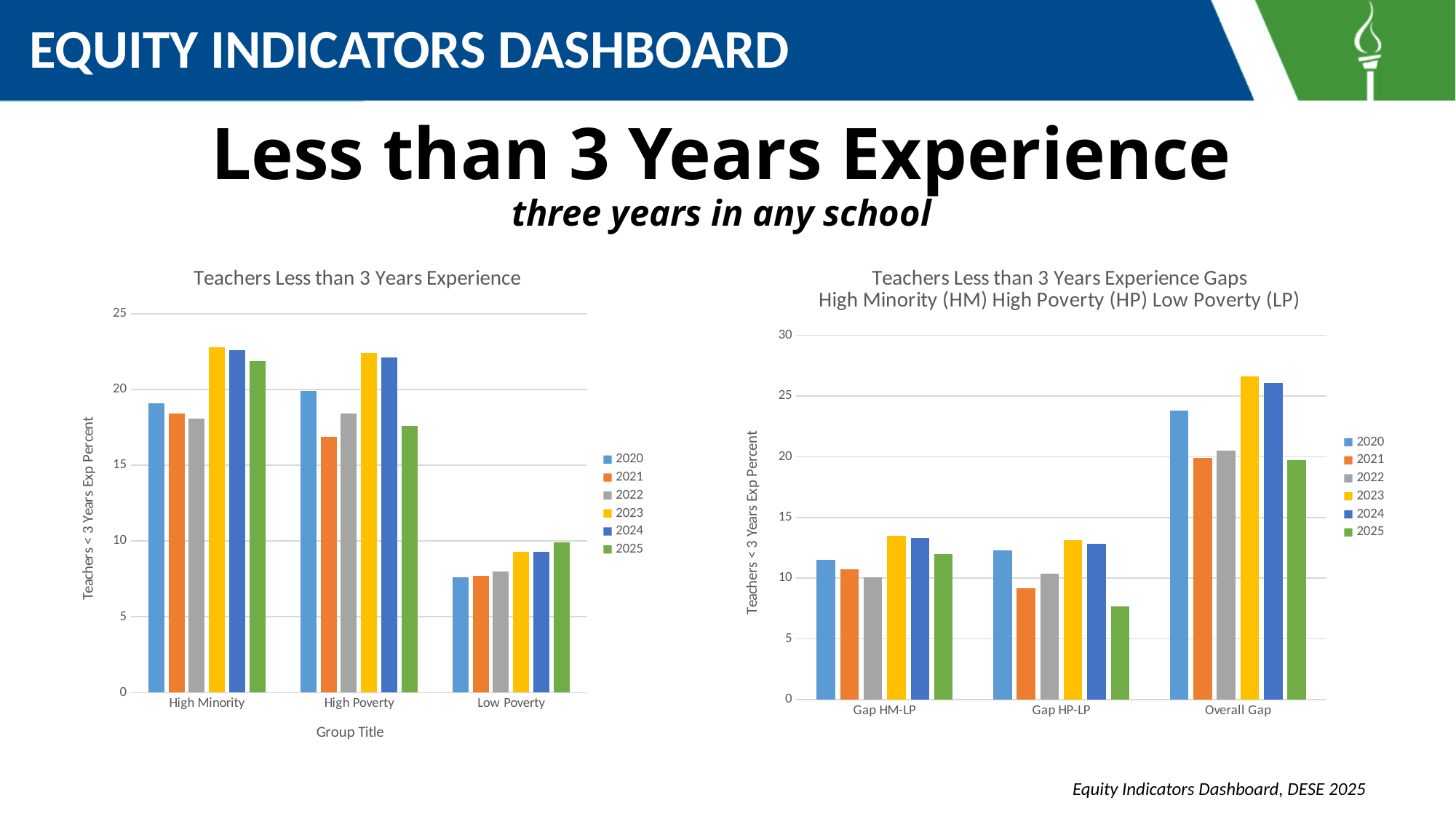
In the left chart, is the value for Low Poverty in 2020 greater or less than 10? less In the left chart, for High Poverty, which is larger: the 2021 value or the 2022 value? 2022 In the right chart, which category has the highest values? Overall Gap In the right chart, is the value for Overall Gap in 2023 greater or less than 25? greater In the right chart, for Gap HP-LP, which year has the lowest value? 2025 In the left chart, how many categories are shown on the x axis? 3 In the right chart titled "Teachers Less than 3 Years Experience Gaps", how many categories are shown on the x axis? 3 In the left chart, do the Low Poverty values generally rise or fall from 2020 to 2025? rise What kind of chart is the left chart titled "Teachers Less than 3 Years Experience"? bar chart In the left chart, is the value for High Minority in 2023 greater or less than 20? greater In the left chart, how many series does the legend list? 6 In the left chart, which category has the lowest value for 2023? Low Poverty